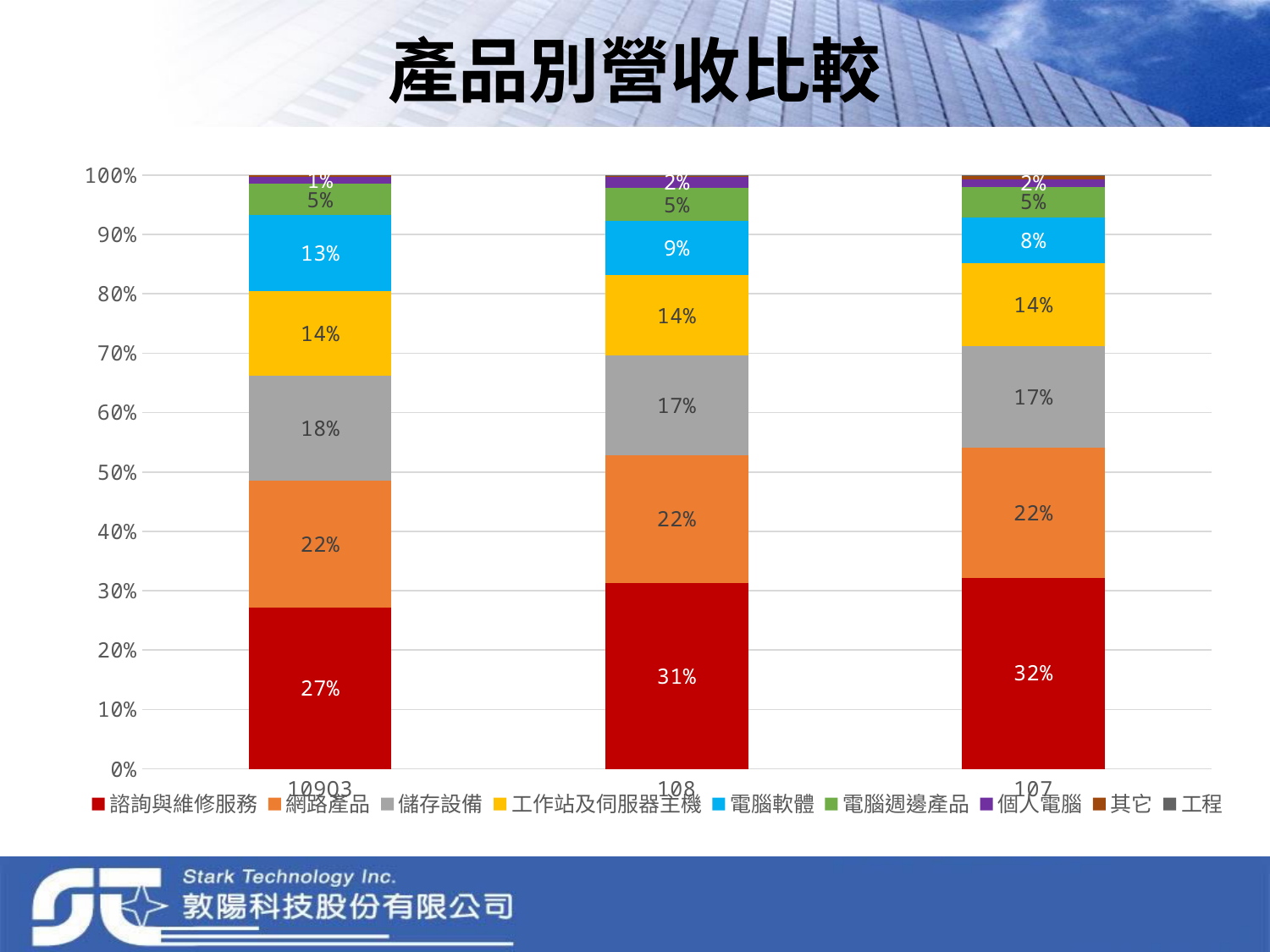
What kind of chart is shown on the slide? Stacked bar chart How many categories are shown on the x axis? 3 What is the difference between the 諮詢與維修服務 values for 107 and 10903? 5% What is the value for 電腦軟體 in the 108 bar? 9% What is the value for 諮詢與維修服務 in the 10903 bar? 27% What is the value for 儲存設備 in the 107 bar? 17% What is the value for 網路產品 in the 107 bar? 22% What is the title of the chart? 產品別營收比較 Which category has the lowest value for 電腦軟體? 107 Which category has the highest value for 諮詢與維修服務? 107 How many series does the legend list? 9 Is the 電腦軟體 value larger for 10903 or for 108? 10903